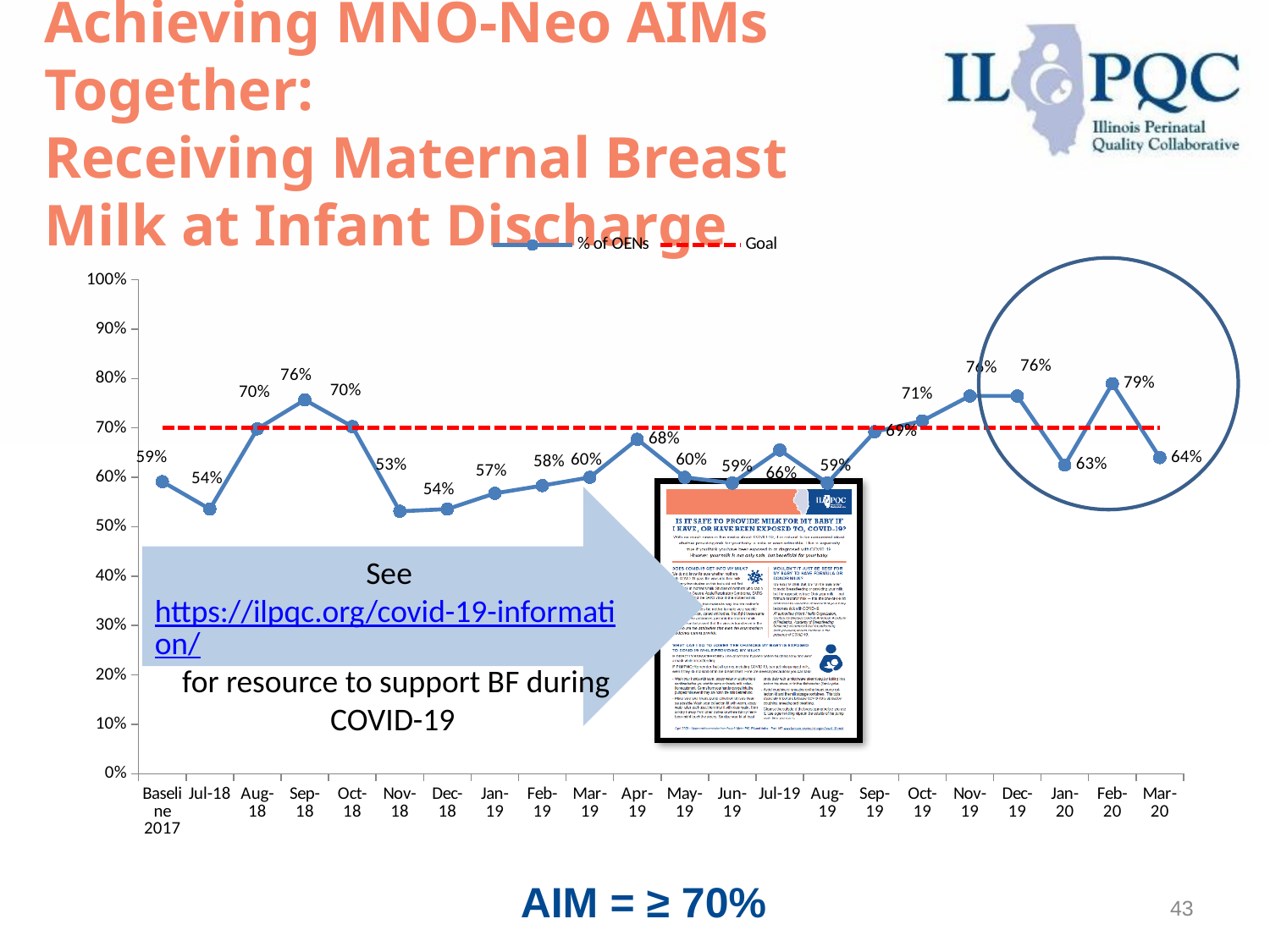
What is the difference between the % of OENs values for Feb-20 and Mar-20? 15 percentage points Which month has the highest % of OENs value? Feb-20 How many data points are plotted on the % of OENs line? 22 Which month has the lowest % of OENs value? Nov-18 What is the difference between the % of OENs values for Sep-18 and Jul-18? 22 percentage points How many series does the legend list? 2 Which has a higher % of OENs value, Apr-19 or Jul-19? Apr-19 What is the % of OENs value for Sep-18? 76% At what value is the dashed Goal line drawn? 70% What is the % of OENs value for Nov-18? 53% What kind of chart is shown on the slide? Line chart What is the % of OENs value for Oct-19? 71%